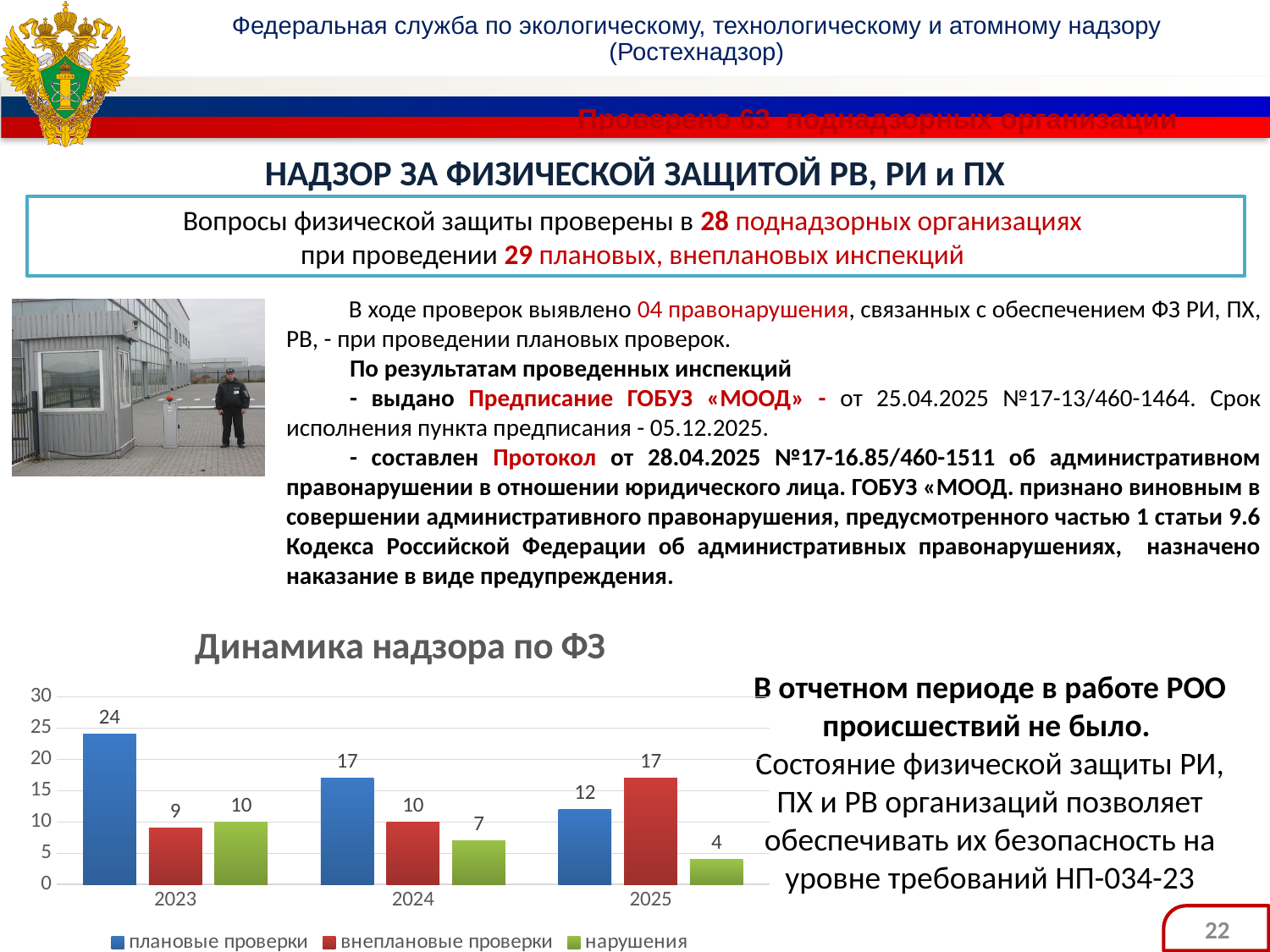
What is the value for плановые проверки in 2023? 24 How many series does the chart legend list? 3 What is the value for нарушения in 2024? 7 Do the values for нарушения rise or fall from 2023 to 2025? fall What is the value for внеплановые проверки in 2025? 17 How many years are shown on the x axis of the chart? 3 What kind of chart is shown on the slide? bar chart Which is larger in 2025: плановые проверки or внеплановые проверки? внеплановые проверки In which year is the value for плановые проверки the highest? 2023 What is the title of the chart? Динамика надзора по ФЗ In which year is the value for нарушения the lowest? 2025 What is the difference between плановые проверки in 2023 and in 2025? 12